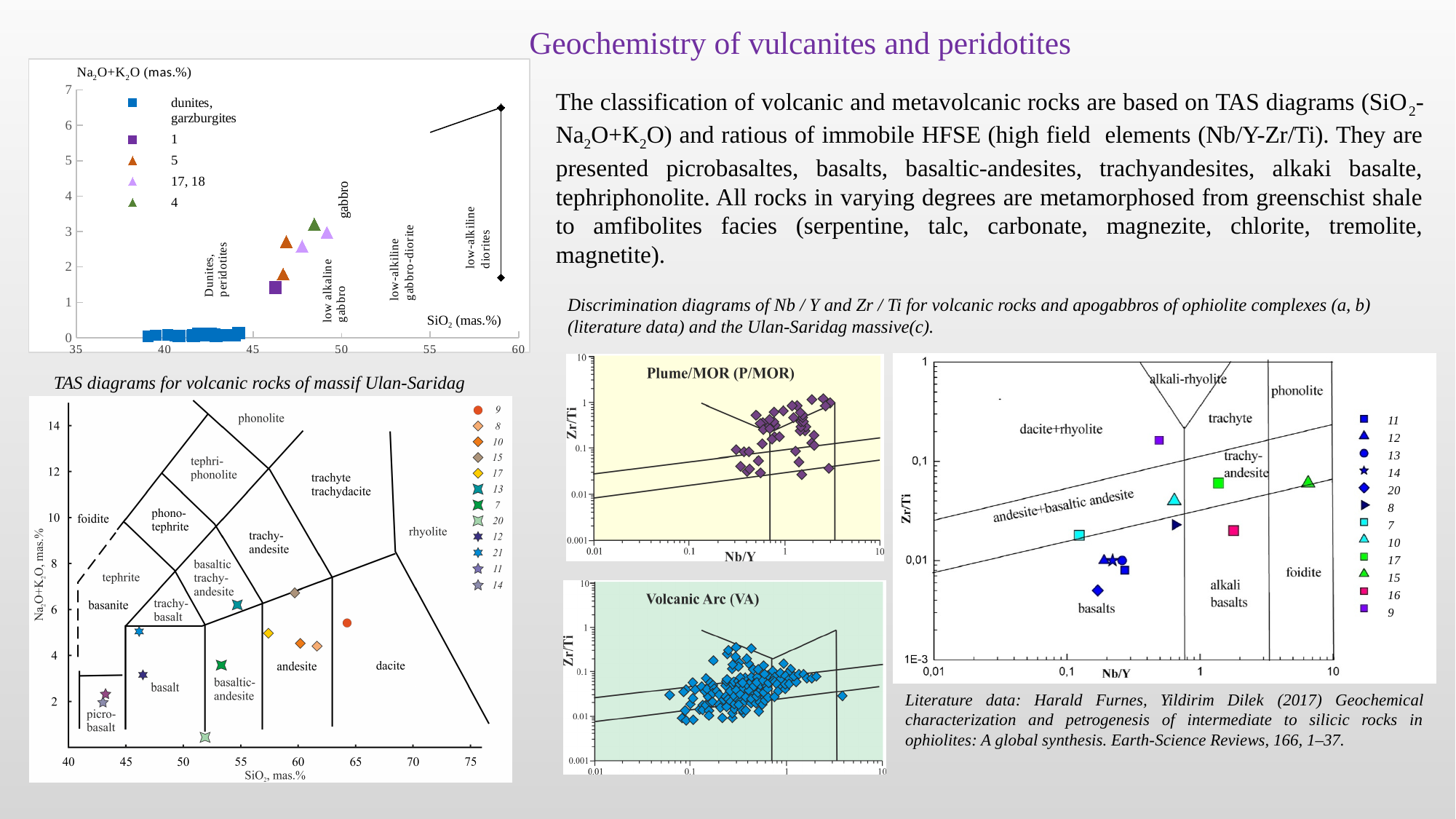
What kind of chart is the top-left TAS diagram (Na2O+K2O vs SiO2)? scatter chart In the Zr/Ti vs Nb/Y diagram for the Ulan-Saridag massive (right-hand chart), is the Zr/Ti value for sample 9 greater or less than 0,1? greater In the bottom-left TAS diagram for volcanic rocks of massif Ulan-Saridag, which sample has the lowest Na2O+K2O value? 20 In the bottom-left TAS diagram for volcanic rocks of massif Ulan-Saridag, in which rock field does sample 14 plot? picro-basalt In the top-left TAS diagram, which has the higher Na2O+K2O value, sample 4 or sample 1? sample 4 In the top-left TAS diagram, is the Na2O+K2O value for sample 4 greater or less than 2? greater In the top-left TAS diagram, are the Na2O+K2O values for the dunites, garzburgites points greater or less than 1? less In the Zr/Ti vs Nb/Y diagram for the Ulan-Saridag massive (right-hand chart), which sample has the highest Nb/Y value? 15 In the bottom-left TAS diagram for volcanic rocks of massif Ulan-Saridag, which sample has the highest SiO2 value? 9 In the bottom-left TAS diagram for volcanic rocks of massif Ulan-Saridag, how many sample numbers does the legend list? 12 In the top-left TAS diagram (Na2O+K2O vs SiO2), how many entries does the legend list? 5